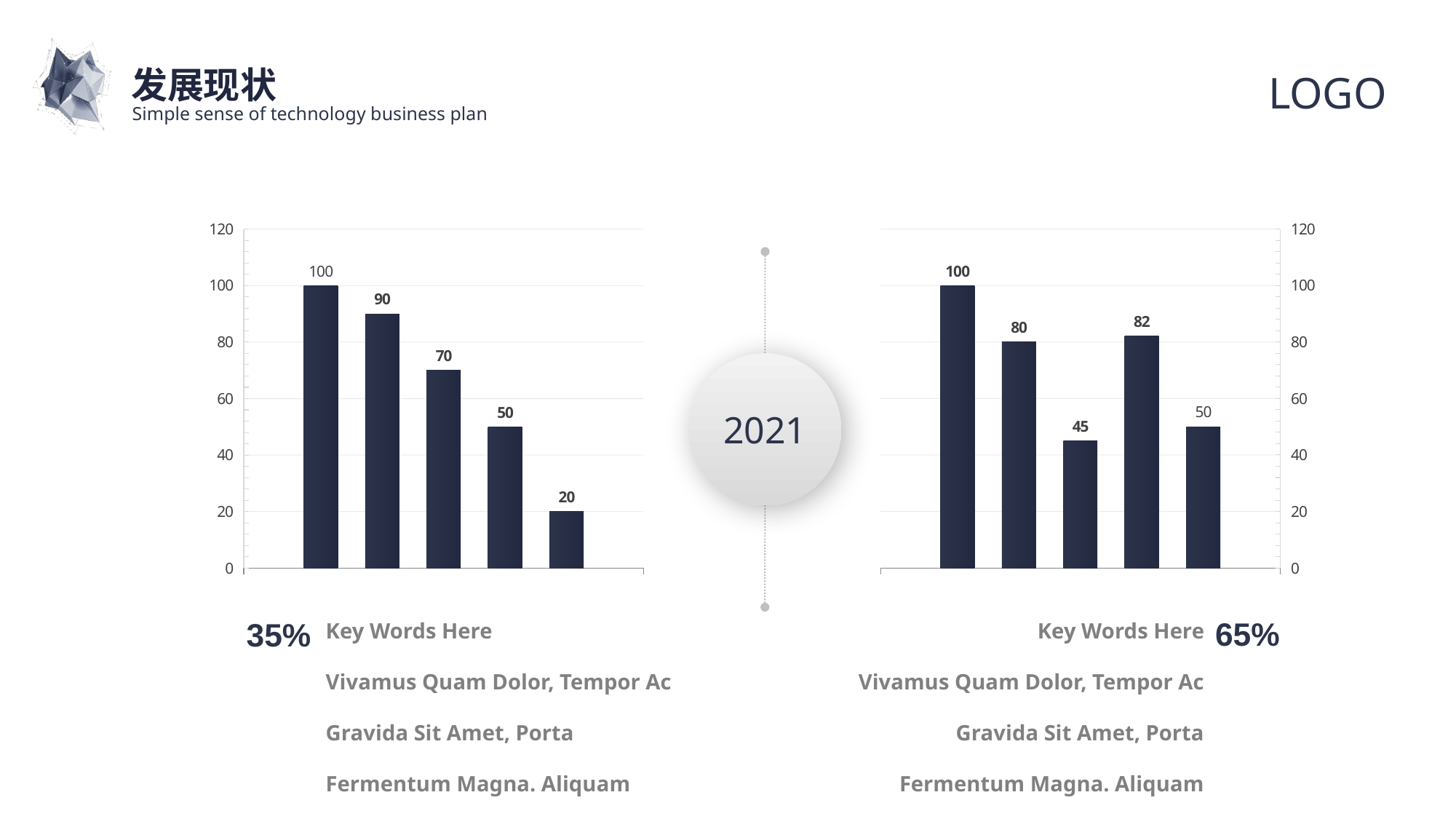
In the right chart, what is the value of the fourth bar? 82 How many bars are in the left chart? 5 What type of chart is the right chart? Bar chart In the left chart, what is the value of the last (fifth) bar? 20 In the left chart, what is the value of the first bar? 100 In the right chart, is the second bar or the fourth bar larger? The fourth bar (82) In the right chart, what is the value of the third bar? 45 In the left chart, what is the difference between the first bar and the last bar? 80 In the right chart, what is the difference between the second bar and the third bar? 35 In the right chart, which bar has the lowest value? The third bar (45) In the left chart, which bar has the highest value? The first bar (100) Do the values in the left chart rise or fall from left to right? Fall